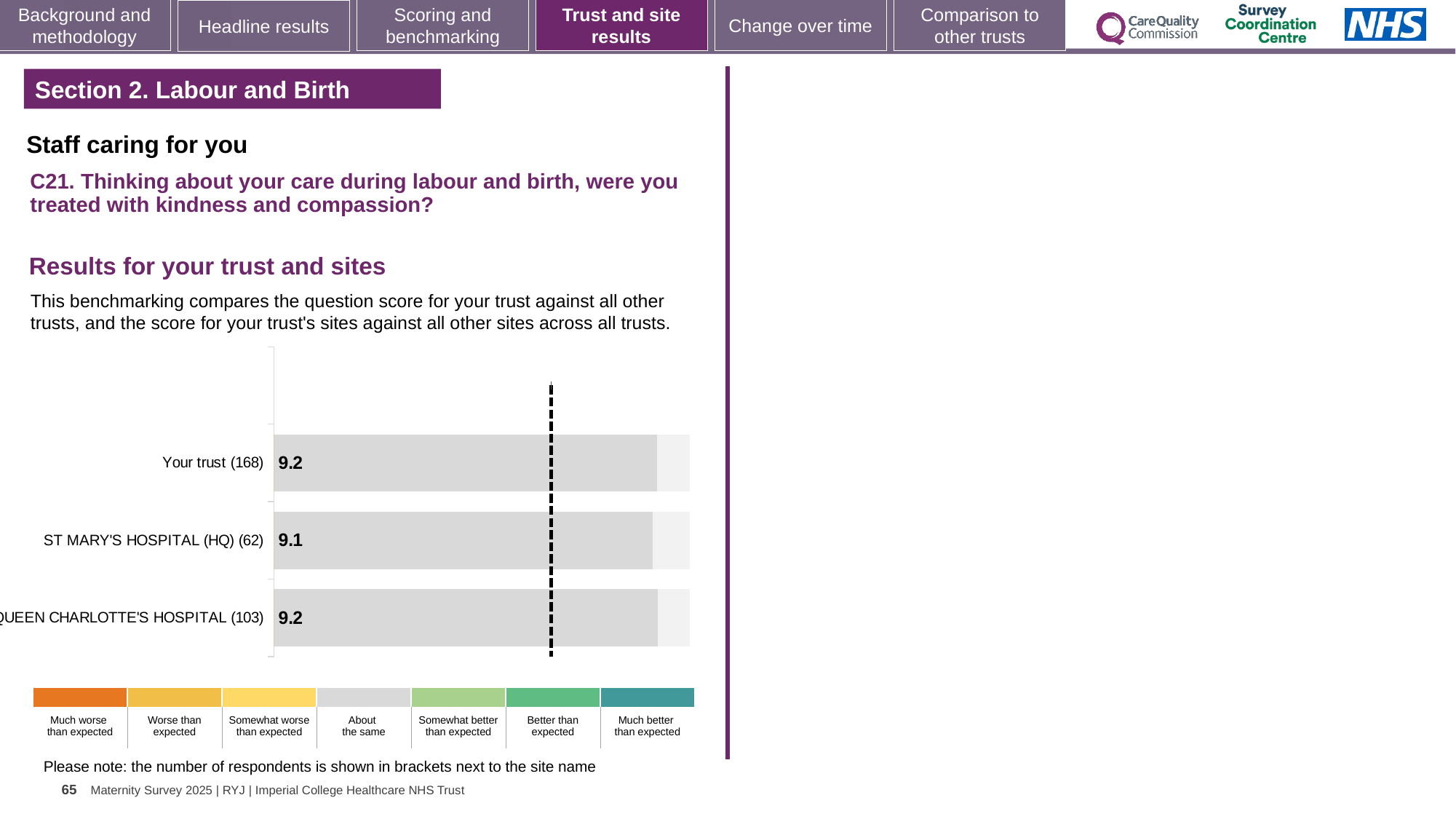
What is the difference between the score for QUEEN CHARLOTTE'S HOSPITAL and the score for ST MARY'S HOSPITAL (HQ)? 0.1 What is the score for QUEEN CHARLOTTE'S HOSPITAL? 9.2 How many categories does the colour key below the chart list? 7 How many respondents are shown in brackets for Your trust? 168 How many respondents are shown in brackets for QUEEN CHARLOTTE'S HOSPITAL? 103 Which is larger, the score for Your trust or the score for ST MARY'S HOSPITAL (HQ)? Your trust What kind of chart is shown on the slide? Bar chart Which site or trust has the lowest score on the chart? ST MARY'S HOSPITAL (HQ) What is the score for Your trust? 9.2 How many bars are shown on the chart? 3 Which category in the colour key does the grey colour of the bars correspond to? About the same What is the score for ST MARY'S HOSPITAL (HQ)? 9.1